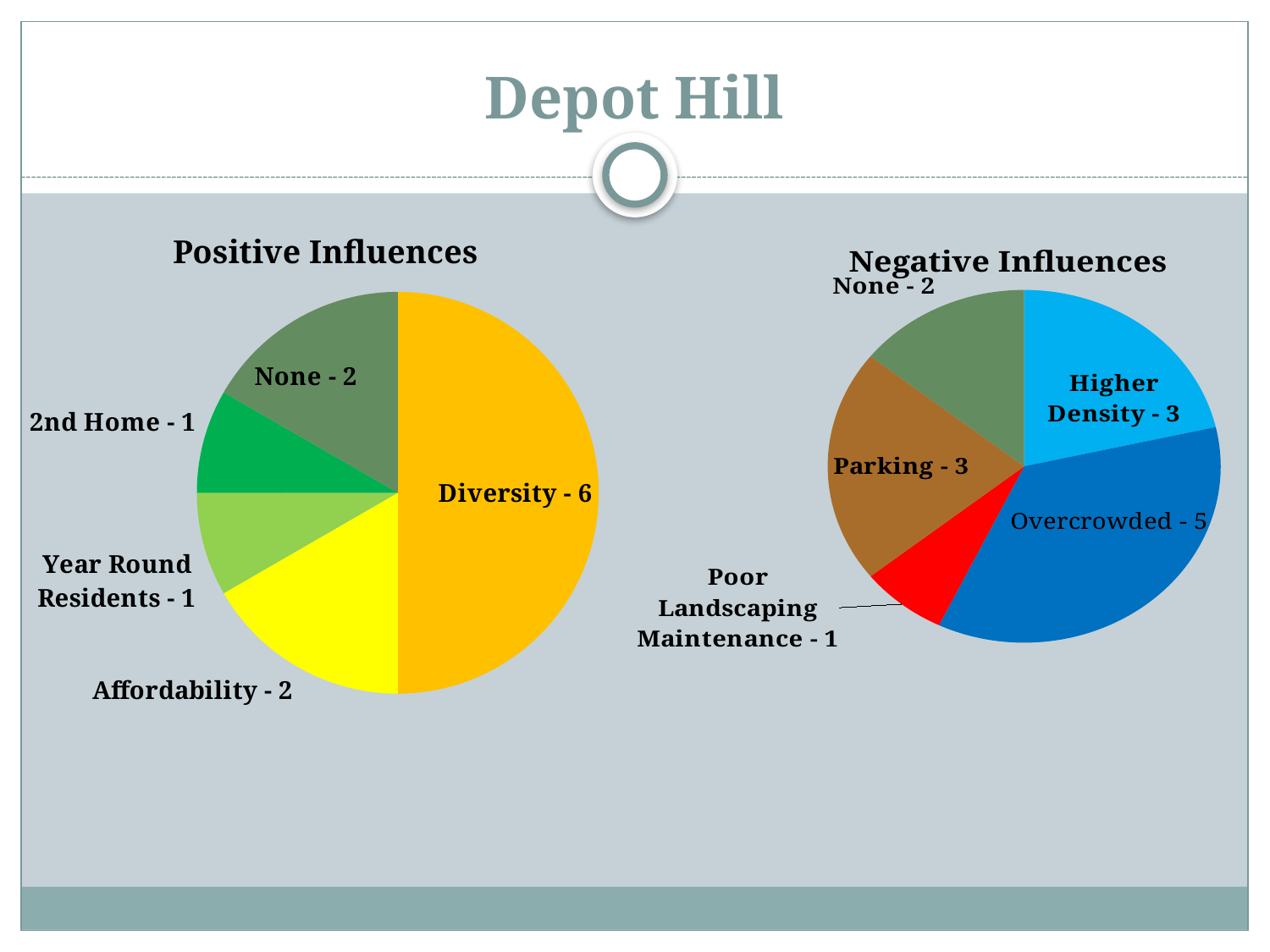
In the Negative Influences chart, what value is shown for Parking? 3 What type of chart is the Positive Influences chart? Pie chart How many categories are shown in the Negative Influences chart? 5 In the Positive Influences chart, what is the difference between the values for Diversity and Affordability? 4 In the Negative Influences chart, what value is shown for Overcrowded? 5 In the Negative Influences chart, which category has the smallest slice? Poor Landscaping Maintenance In the Positive Influences chart, which category has the largest slice? Diversity What is the title of the chart on the right side of the slide? Negative Influences How many categories are shown in the Positive Influences chart? 5 In the Negative Influences chart, which is larger, Overcrowded or Higher Density? Overcrowded In the Positive Influences chart, what share of the total does Diversity represent? 50% In the Positive Influences chart, what value is shown for Diversity? 6